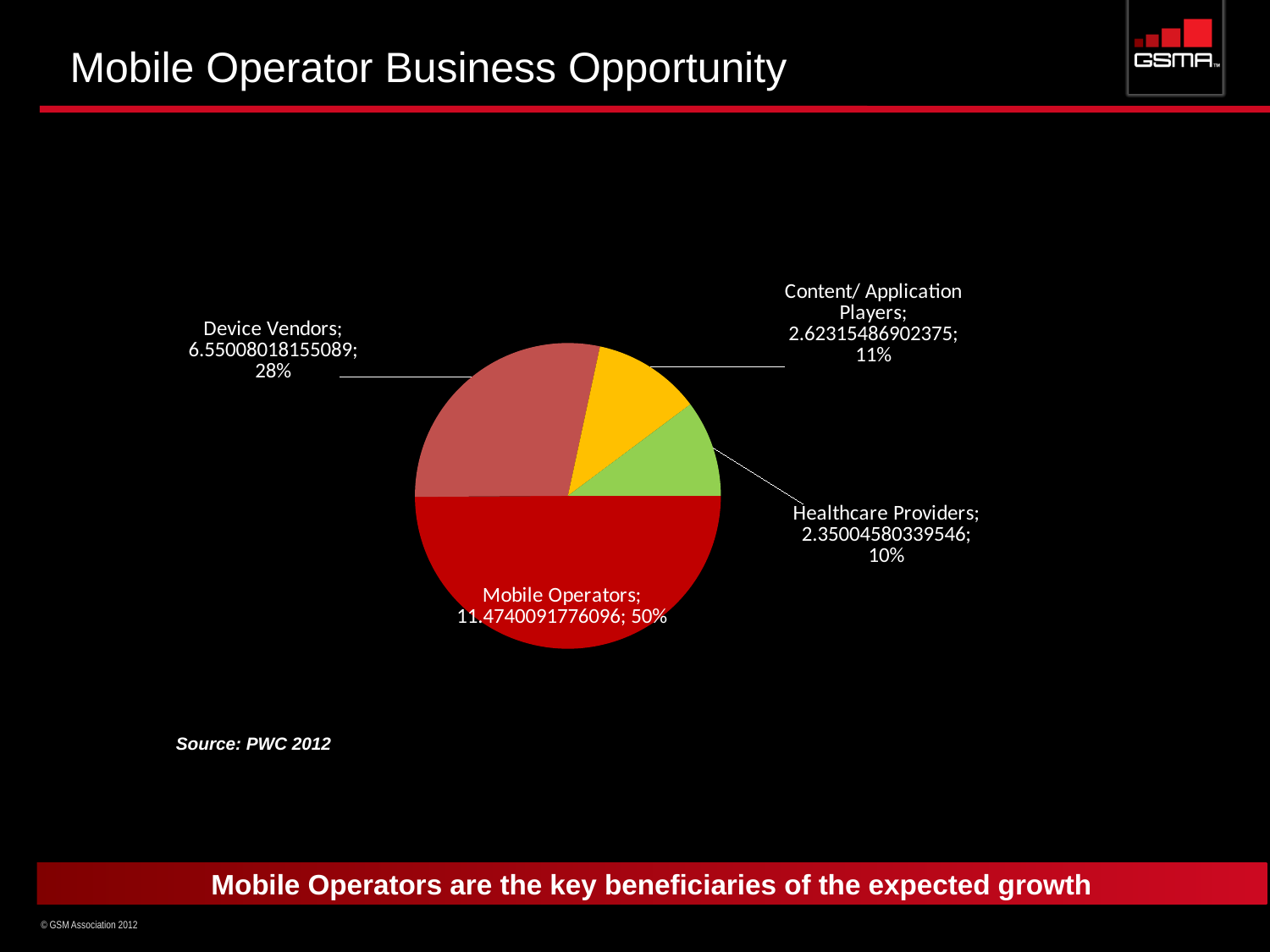
What kind of chart is shown on the slide? pie chart What value is printed for the Healthcare Providers slice? 2.35004580339546 What value is printed for the Device Vendors slice? 6.55008018155089 Which slice is larger, Device Vendors or Content/ Application Players? Device Vendors What percentage share does the Device Vendors slice have? 28% What percentage share does the Healthcare Providers slice have? 10% What is the difference in percentage share between Mobile Operators and Device Vendors? 22% What percentage share does the Content/ Application Players slice have? 11% How many slices does the pie chart have? 4 Which category has the largest slice of the pie? Mobile Operators Which category has the smallest slice of the pie? Healthcare Providers